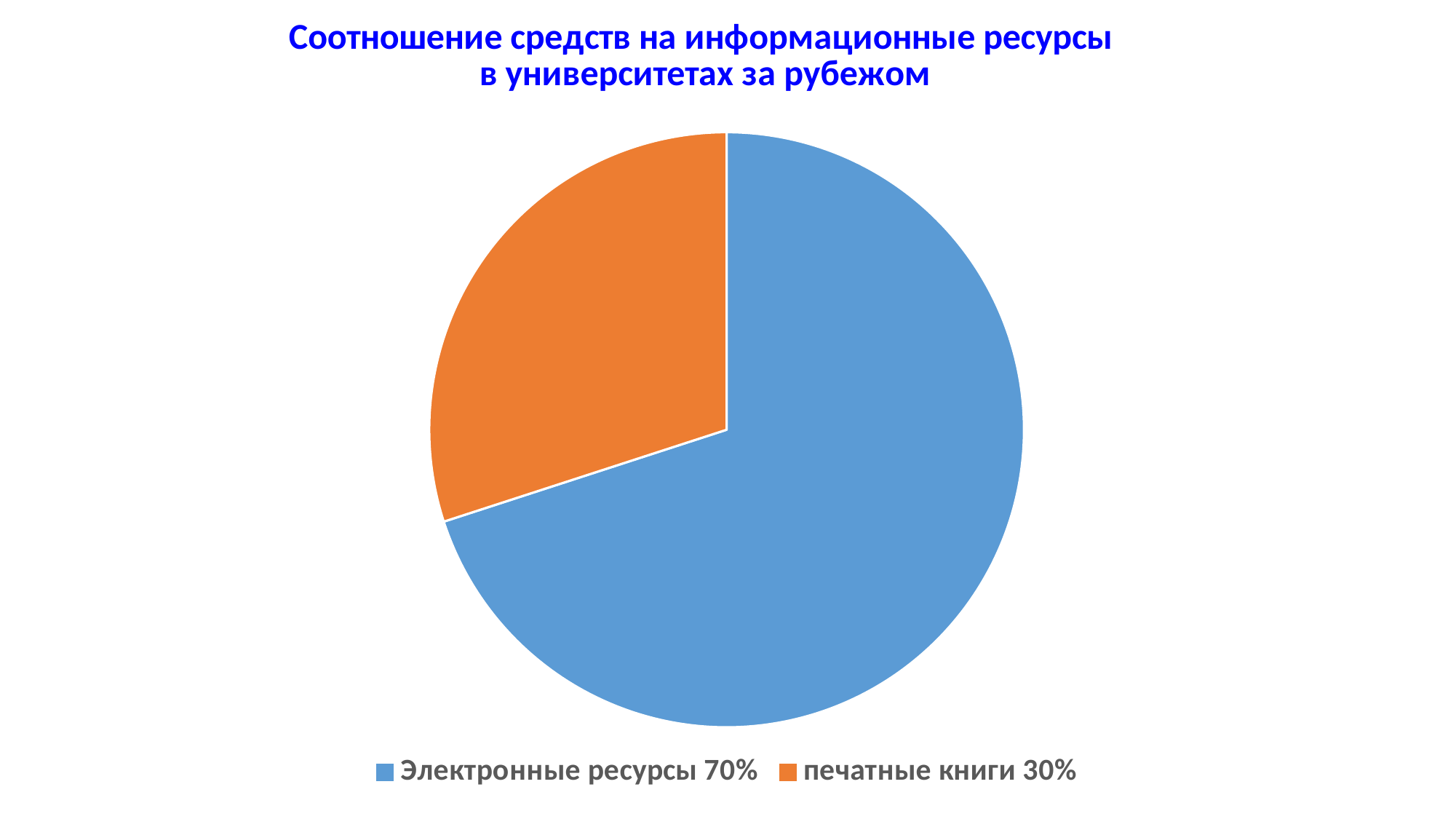
What is the title of the chart? Соотношение средств на информационные ресурсы в университетах за рубежом How many slices does the pie chart have? 2 What kind of chart is shown on the slide? Pie chart What share of the pie is Электронные ресурсы? 70% What colour is the slice for печатные книги? Orange Which category has the largest share of the pie? Электронные ресурсы What is the difference between the share for Электронные ресурсы and the share for печатные книги? 40% How many entries does the legend list? 2 Which is larger, the share for Электронные ресурсы or the share for печатные книги? Электронные ресурсы Which category has the smallest share of the pie? печатные книги What share of the pie is печатные книги? 30%